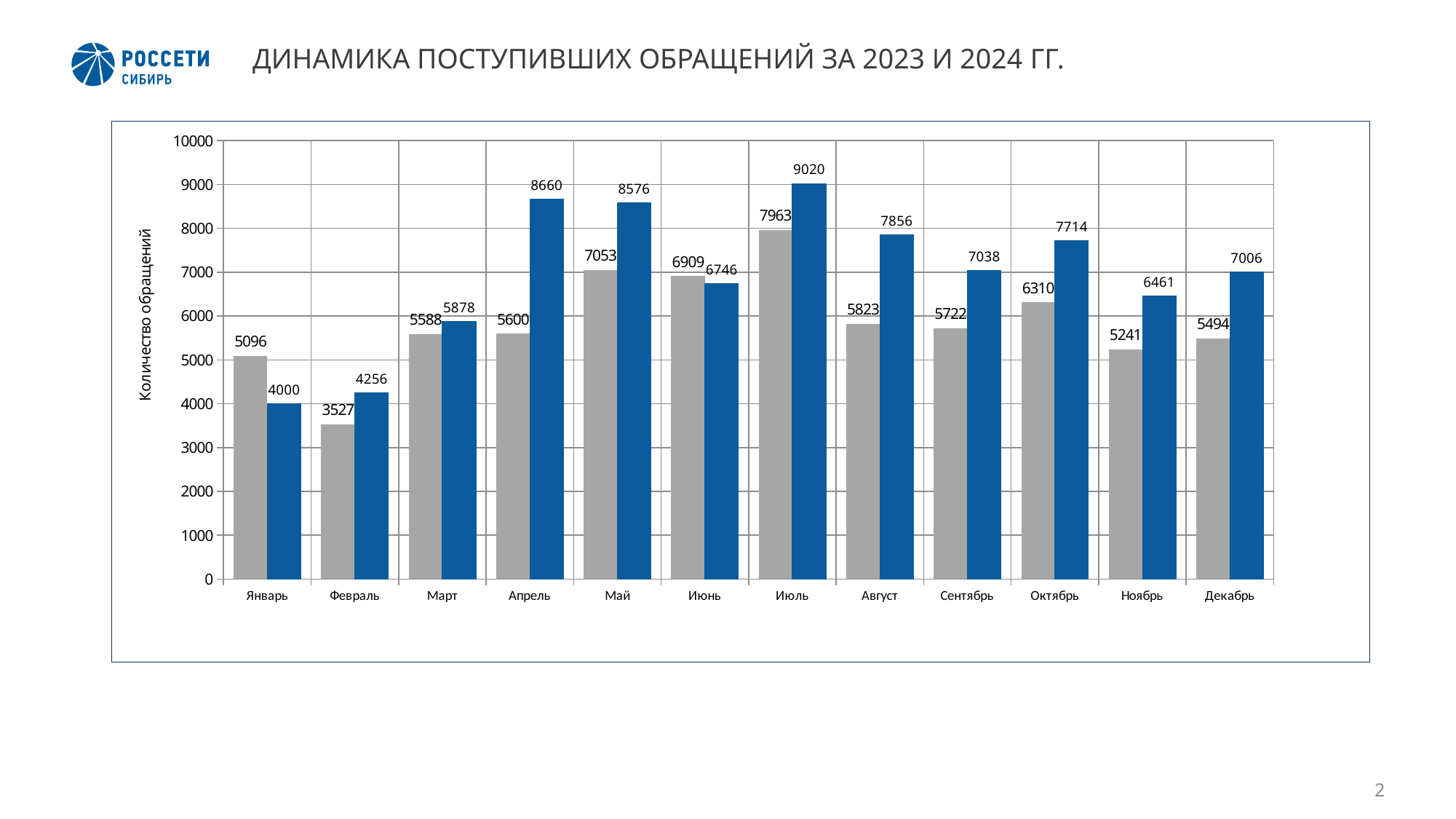
Which month has the lowest grey bar? Февраль What is the value of the blue bar for Апрель? 8660 What is the difference between the blue and grey bars for Апрель? 3060 Is the value of the blue bar for Май greater or less than 8000? greater Which month has the lowest blue bar? Январь Which month has the highest blue bar? Июль What is the value of the blue bar for Июль? 9020 What is the label of the vertical axis? Количество обращений What is the value of the grey bar for Февраль? 3527 What kind of chart is shown on the slide? bar chart Which is larger for Июнь, the grey bar or the blue bar? the grey bar How many months are shown on the x axis? 12